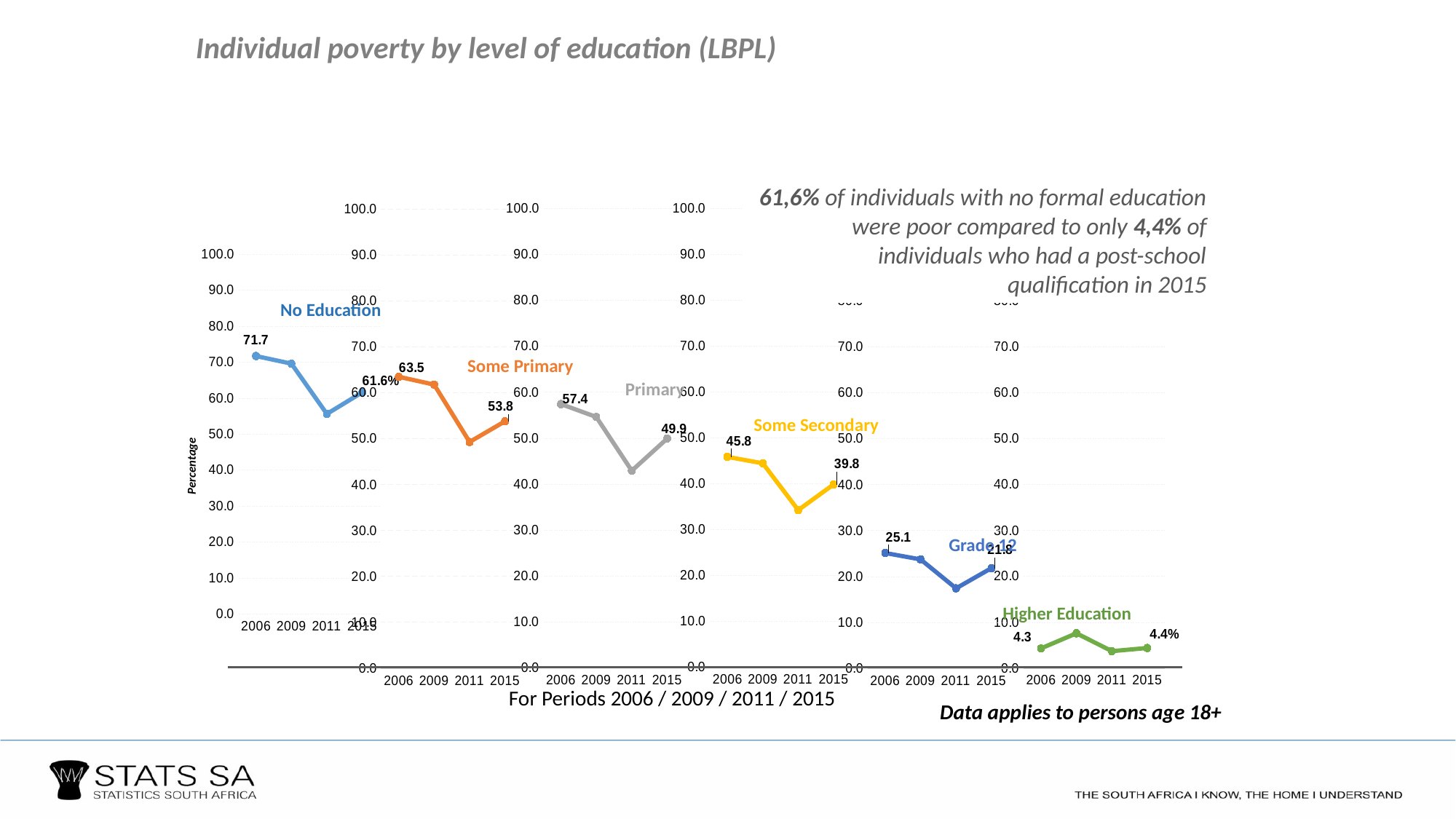
In the Grade 12 chart, what is the value for 2015? 21.8 In the Grade 12 chart, which year has the lowest value? 2011 In the No Education chart, what is the value for 2006? 71.7 How many time periods are plotted in each chart? 4 What kind of chart is used for each education level? line chart In the Some Primary chart, what is the value for 2006? 63.5 In the Some Secondary chart, what is the value for 2006? 45.8 In the No Education chart, what is the value for 2015? 61.6% In the Primary chart, what is the value for 2015? 49.9 In the Some Secondary chart, is the 2011 value greater or less than 40.0? less In the Higher Education chart, what is the value for 2015? 4.4% In the Some Primary chart, what is the difference between the 2006 and 2015 values? 9.7